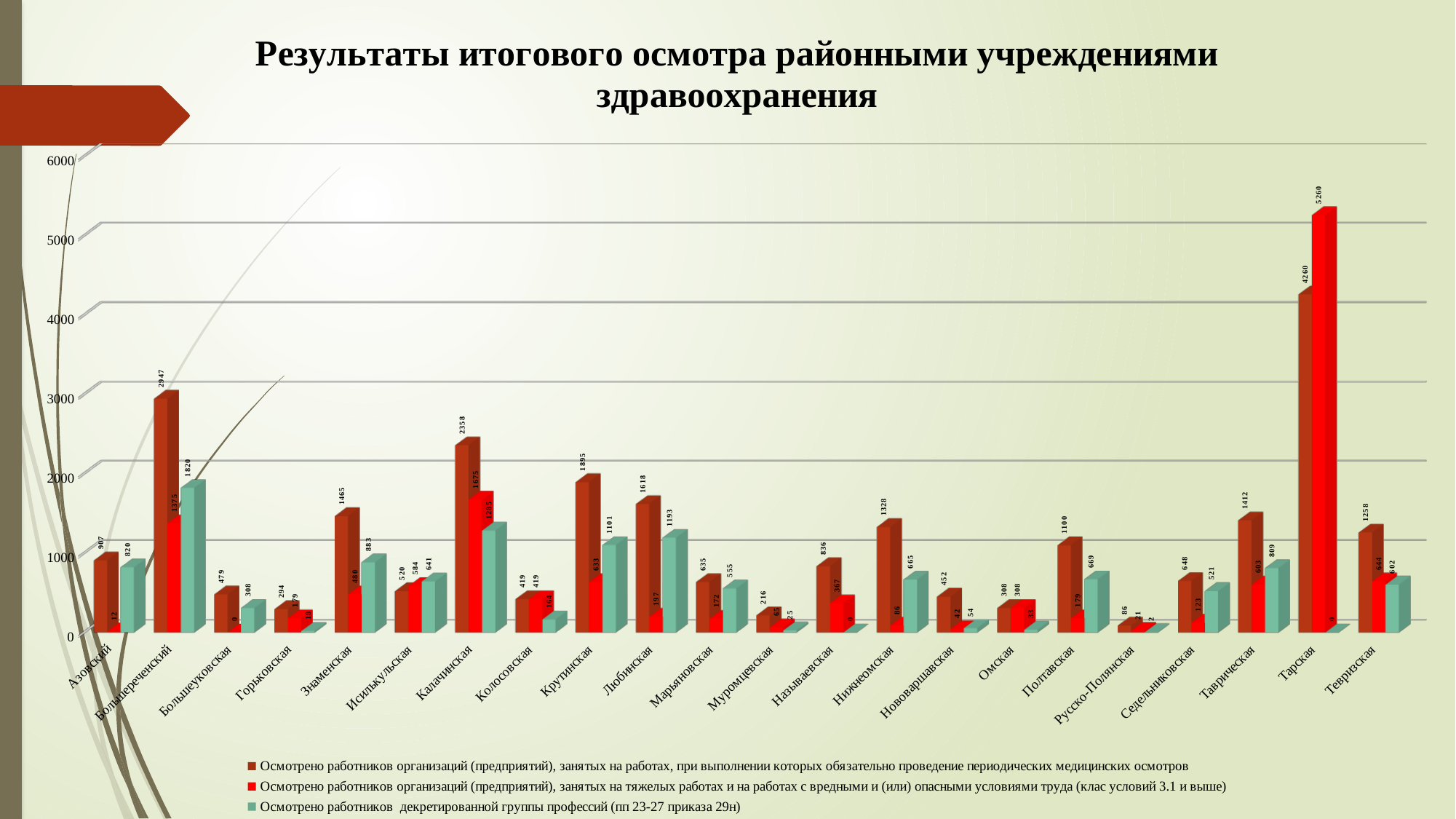
What is the title of the chart? Результаты итогового осмотра районными учреждениями здравоохранения What is the value of the first (brown) series for Большереченский? 2947 Which district has the highest value in the red series (workers in heavy/hazardous conditions)? Тарская Which is larger for Исилькульская: the brown series value or the teal series value? the teal series value (641) What is the value of the second (red) series for Тарская? 5260 What is the difference between the red and brown series values for Тарская? 1000 Which district has the highest value in the teal series (decreed group of professions)? Большереченский What type of chart is shown on the slide? bar chart How many districts (categories) are shown on the x axis? 22 How many series does the legend list? 3 What is the value of the third (teal) series for Калачинская? 1285 Is the brown series value for Крутинская greater or less than 2000? less